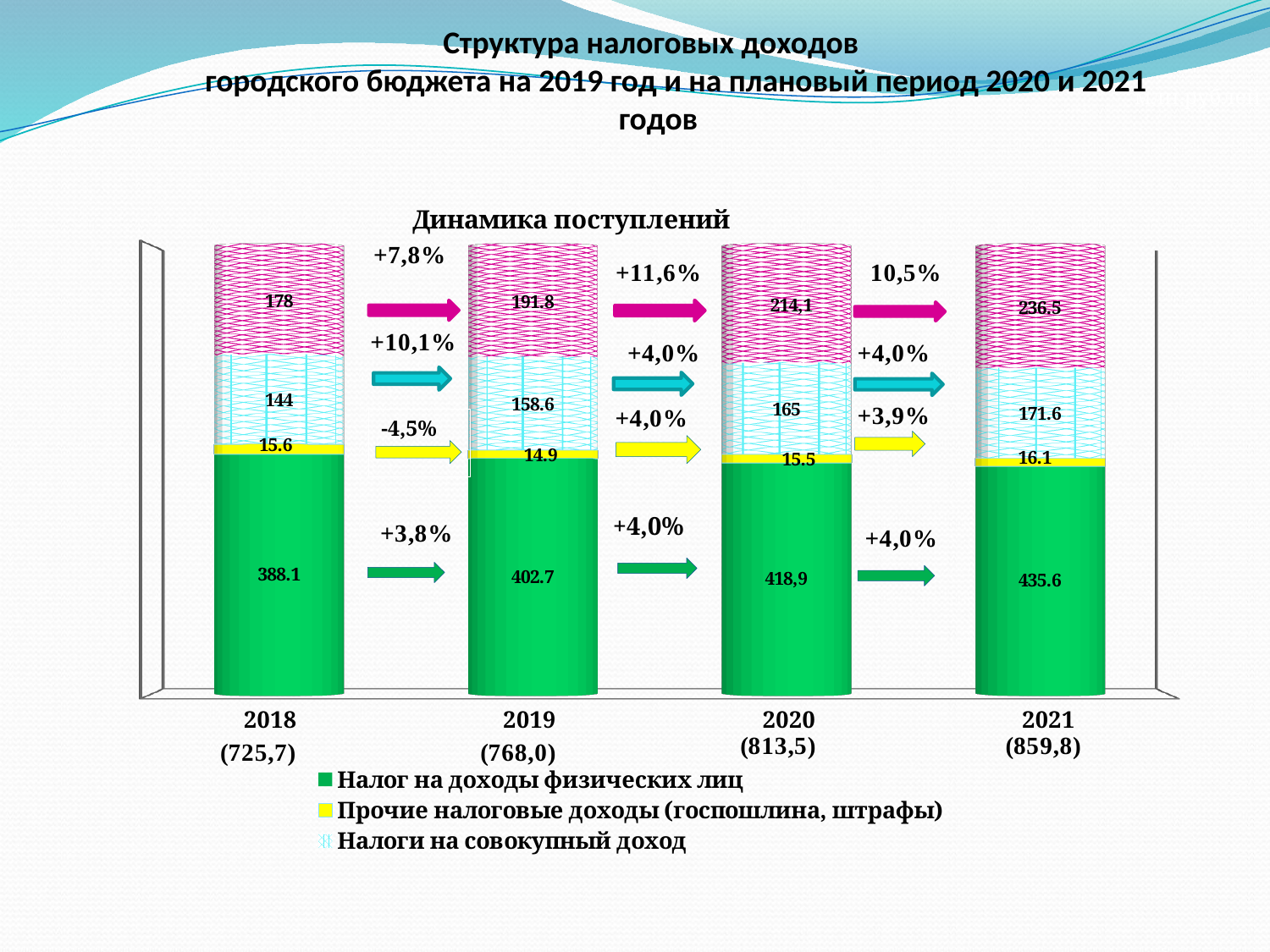
How many series does the legend list? 3 What is the value of Налоги на совокупный доход for 2021? 171.6 What is the value of Налог на доходы физических лиц for 2018? 388.1 How many years are shown on the x axis of the chart? 4 In which year is Прочие налоговые доходы (госпошлина, штрафы) the lowest? 2019 Which year has the larger value for Налоги на совокупный доход, 2019 or 2020? 2020 What kind of chart is shown on the slide? Stacked bar chart In which year is Налог на доходы физических лиц the highest? 2021 Does Налог на доходы физических лиц rise or fall from 2018 to 2021? Rises What is the total shown for the 2020 bar? 813,5 What is the value of Прочие налоговые доходы (госпошлина, штрафы) for 2019? 14.9 By how much does Налог на доходы физических лиц in 2021 exceed the value in 2018? 47.5